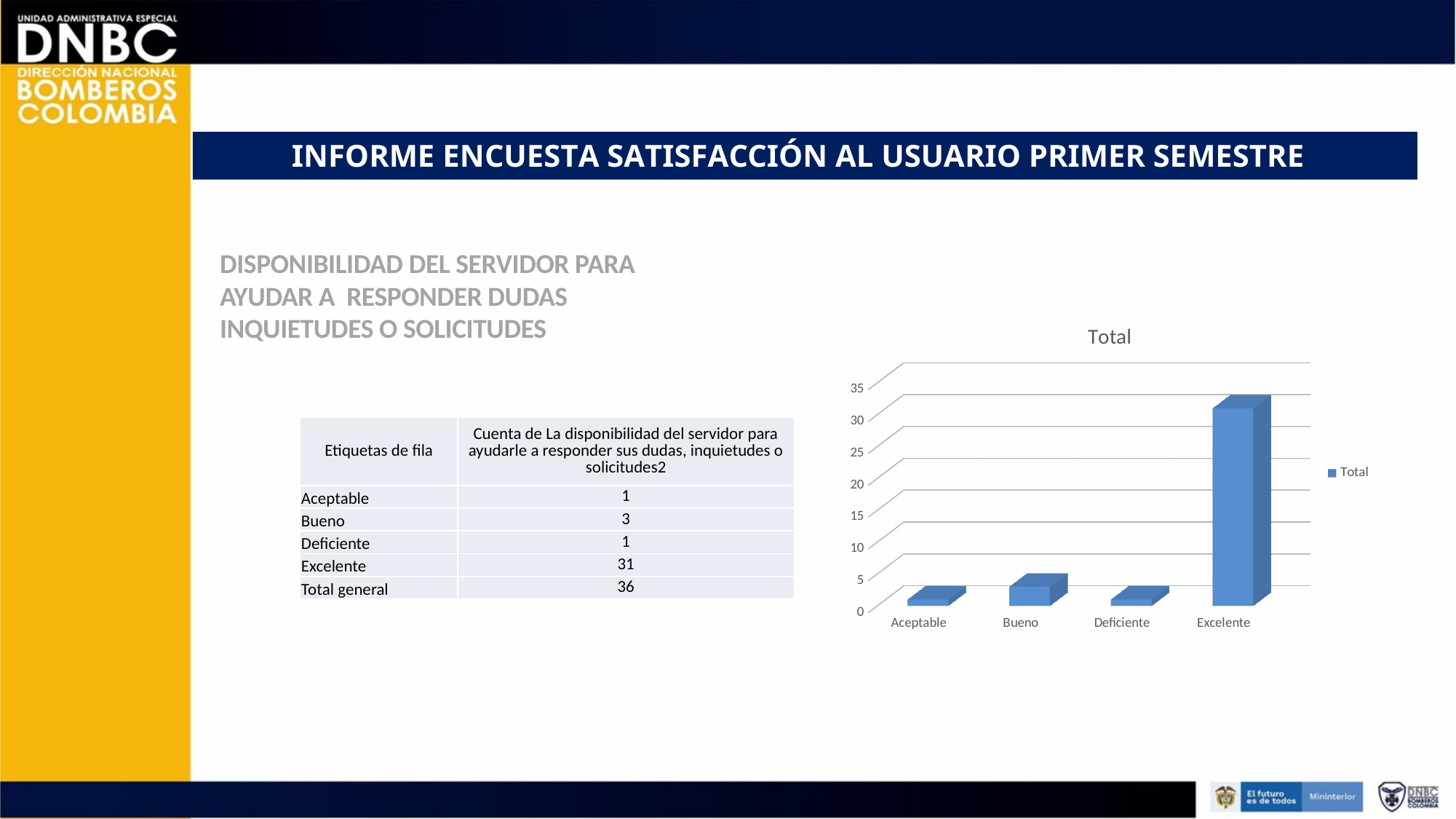
Is the value for Bueno greater or less than 5? less Is the value for Excelente greater or less than 30? greater What kind of chart is shown on the slide? bar chart How many categories are shown on the x axis of the chart? 4 What is the title of the chart? Total According to the table on the slide, what is the value for Excelente? 31 How many series does the chart legend list? 1 According to the table on the slide, what is the Total general? 36 Which category has the highest value in the chart? Excelente Which is larger, the value for Bueno or the value for Deficiente? Bueno According to the table on the slide, what is the value for Bueno? 3 According to the table on the slide, what is the difference between the values for Excelente and Bueno? 28